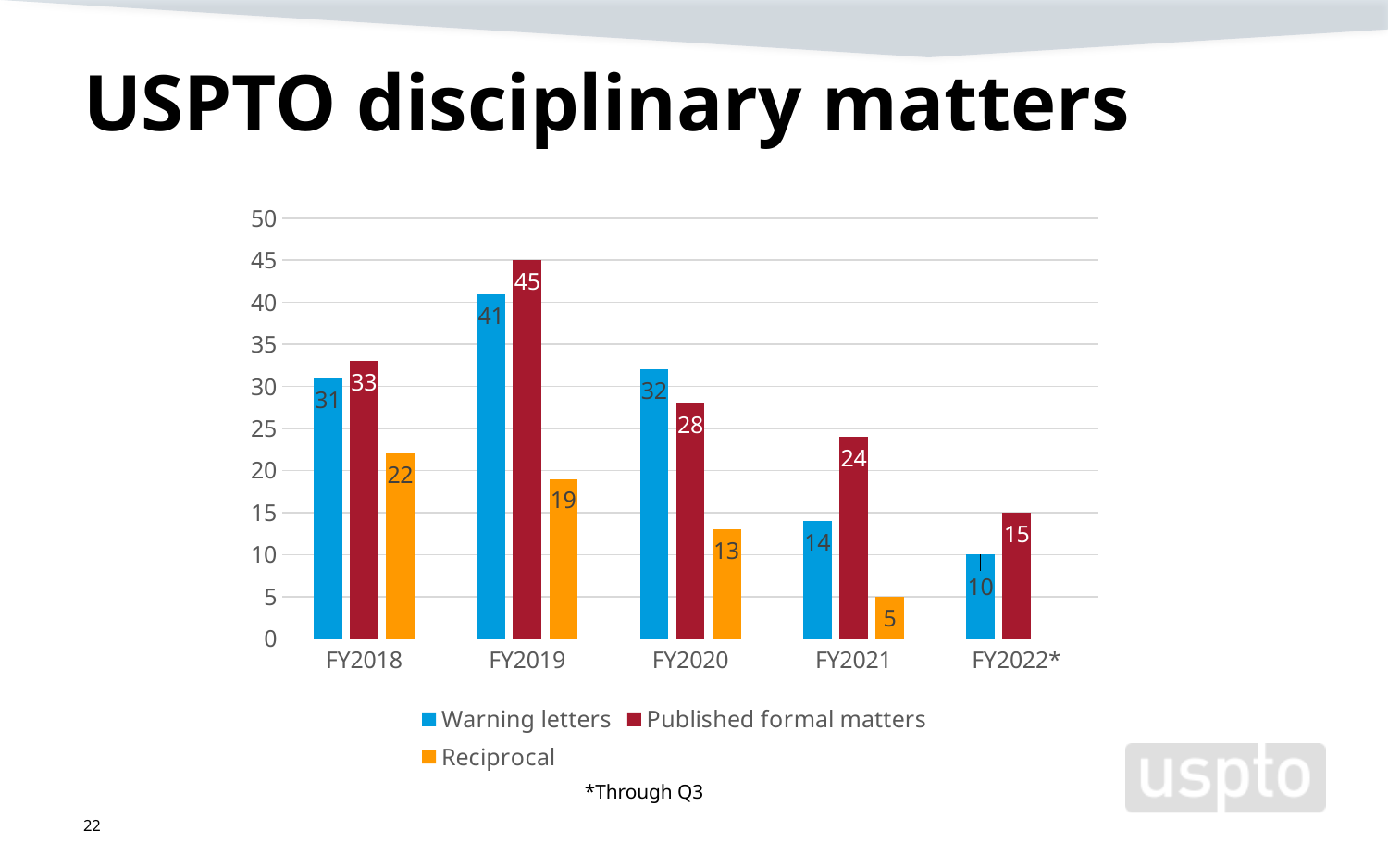
How many fiscal year categories are shown on the x axis? 5 What is the value for Warning letters in FY2019? 41 In which fiscal year is the Warning letters value lowest? FY2022* What is the value for Published formal matters in FY2022*? 15 In FY2020, which is larger: Warning letters or Published formal matters? Warning letters What type of chart is shown on the slide? Bar chart What does the asterisk on FY2022* indicate, according to the note below the chart? Through Q3 What is the difference between Published formal matters and Warning letters in FY2021? 10 In which fiscal year is the Published formal matters value highest? FY2019 How many series does the legend list? 3 Do the Reciprocal values rise or fall from FY2018 to FY2021? Fall What is the value for Reciprocal in FY2018? 22